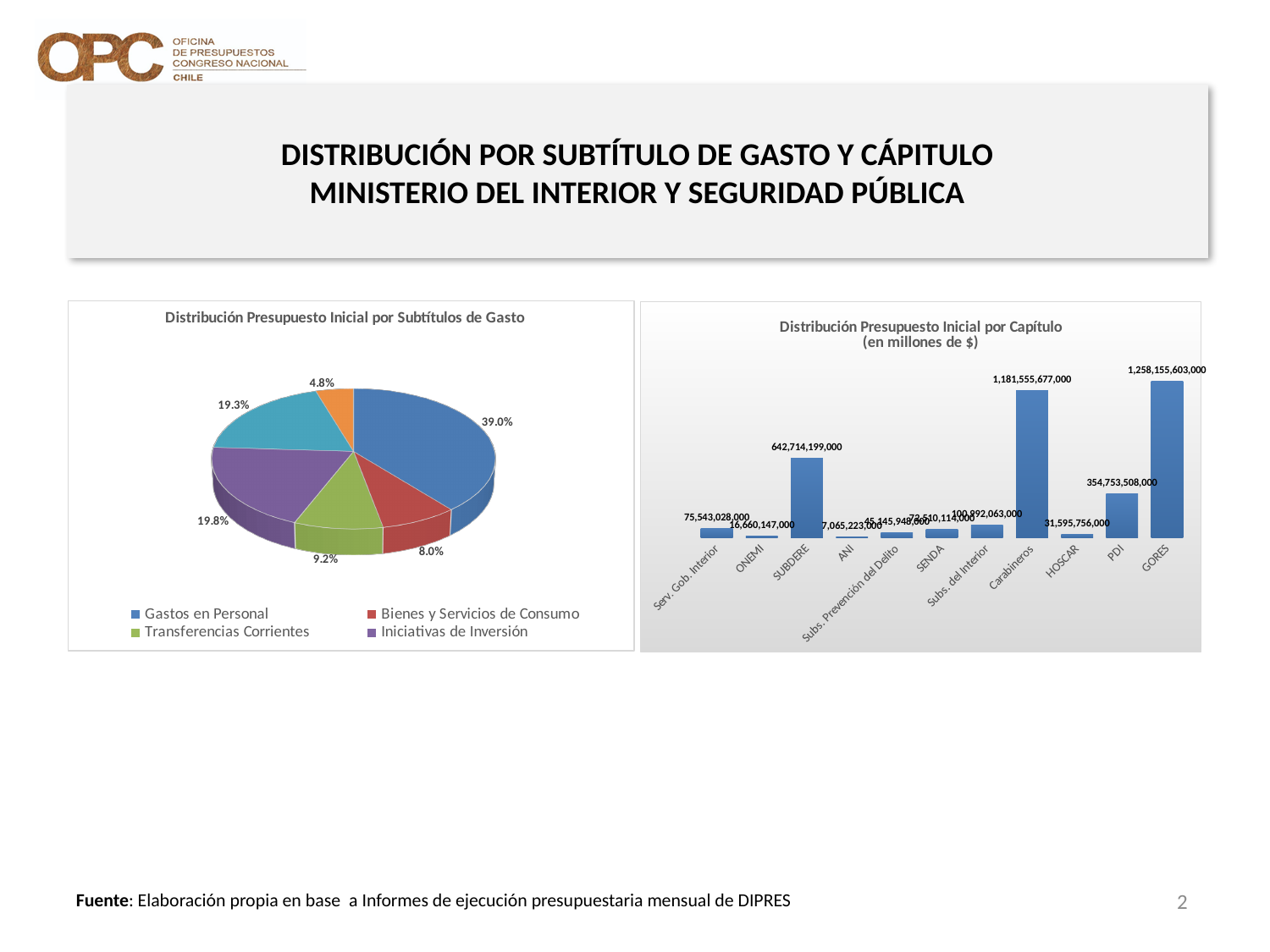
In the bar chart 'Distribución Presupuesto Inicial por Capítulo', what is the value for Carabineros? 1,181,555,677,000 In the pie chart 'Distribución Presupuesto Inicial por Subtítulos de Gasto', what share does Iniciativas de Inversión have? 19.8% How many slices does the pie chart on the left have? 6 How many entries does the legend of the pie chart on the left list? 4 In the pie chart on the left, which legend category has the largest slice? Gastos en Personal In the pie chart 'Distribución Presupuesto Inicial por Subtítulos de Gasto', what share does Bienes y Servicios de Consumo have? 8.0% In the pie chart 'Distribución Presupuesto Inicial por Subtítulos de Gasto', what share does Gastos en Personal have? 39.0% In the bar chart 'Distribución Presupuesto Inicial por Capítulo', what is the difference between GORES and Carabineros? 76,599,926,000 In the bar chart 'Distribución Presupuesto Inicial por Capítulo', what is the value for GORES? 1,258,155,603,000 How many capítulos are shown in the bar chart on the right? 11 In the bar chart 'Distribución Presupuesto Inicial por Capítulo', which capítulo has the lowest value? ANI In the bar chart 'Distribución Presupuesto Inicial por Capítulo', which is larger, SUBDERE or PDI? SUBDERE